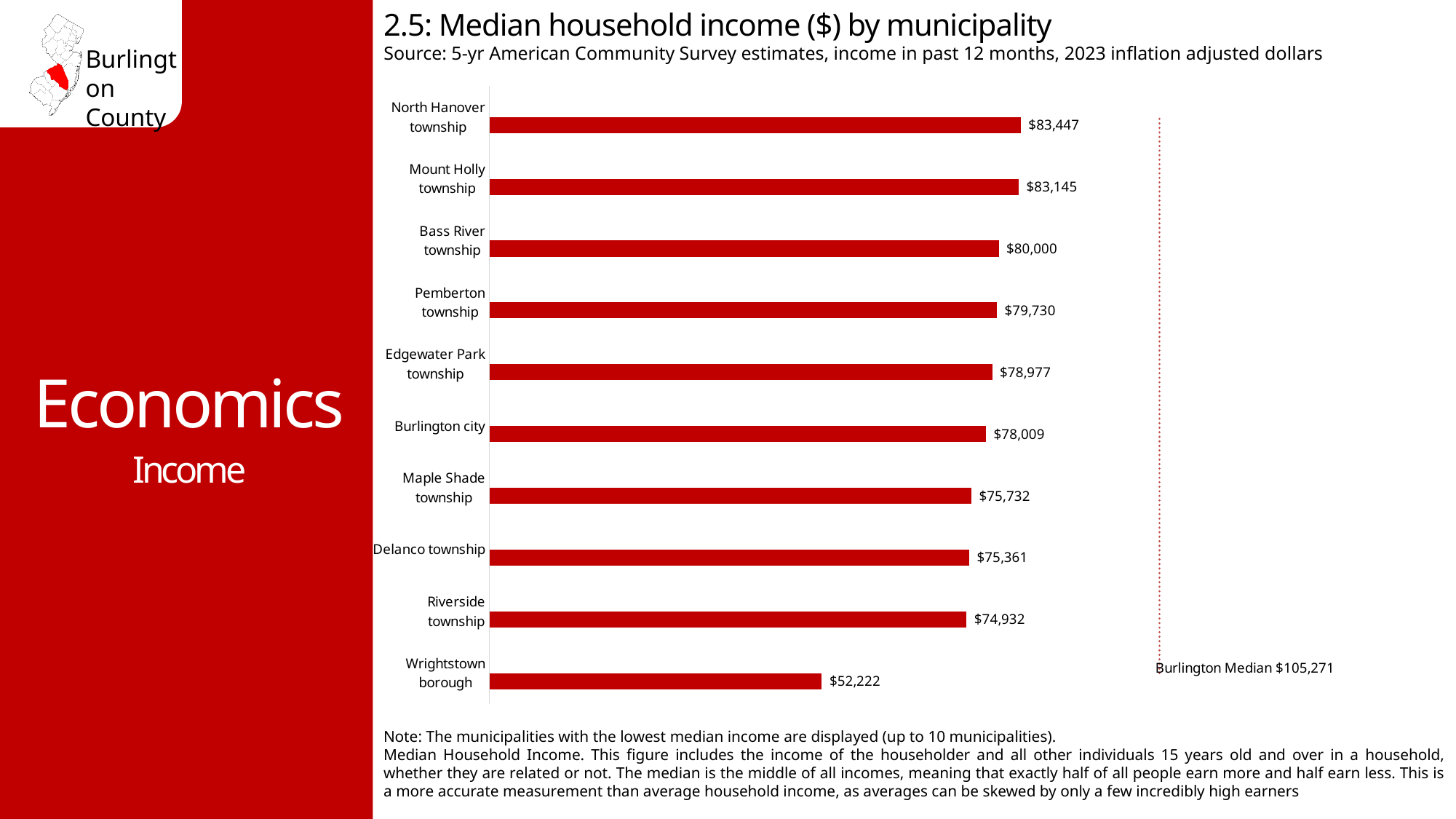
What is the median household income for Bass River township? $80,000 Which municipality has the lowest median household income shown on the chart? Wrightstown borough What kind of chart is shown on the slide? Bar chart What is the median household income for Burlington city? $78,009 What is the difference between the median household income of Pemberton township and Wrightstown borough? $27,508 What is the title of the chart? 2.5: Median household income ($) by municipality What is the difference between the median household income of North Hanover township and Mount Holly township? $302 How many municipalities are shown on the chart? 10 Which has a higher median household income, Edgewater Park township or Maple Shade township? Edgewater Park township What is the Burlington median household income indicated by the dotted line? $105,271 What is the median household income for Riverside township? $74,932 Which municipality has the highest median household income shown on the chart? North Hanover township